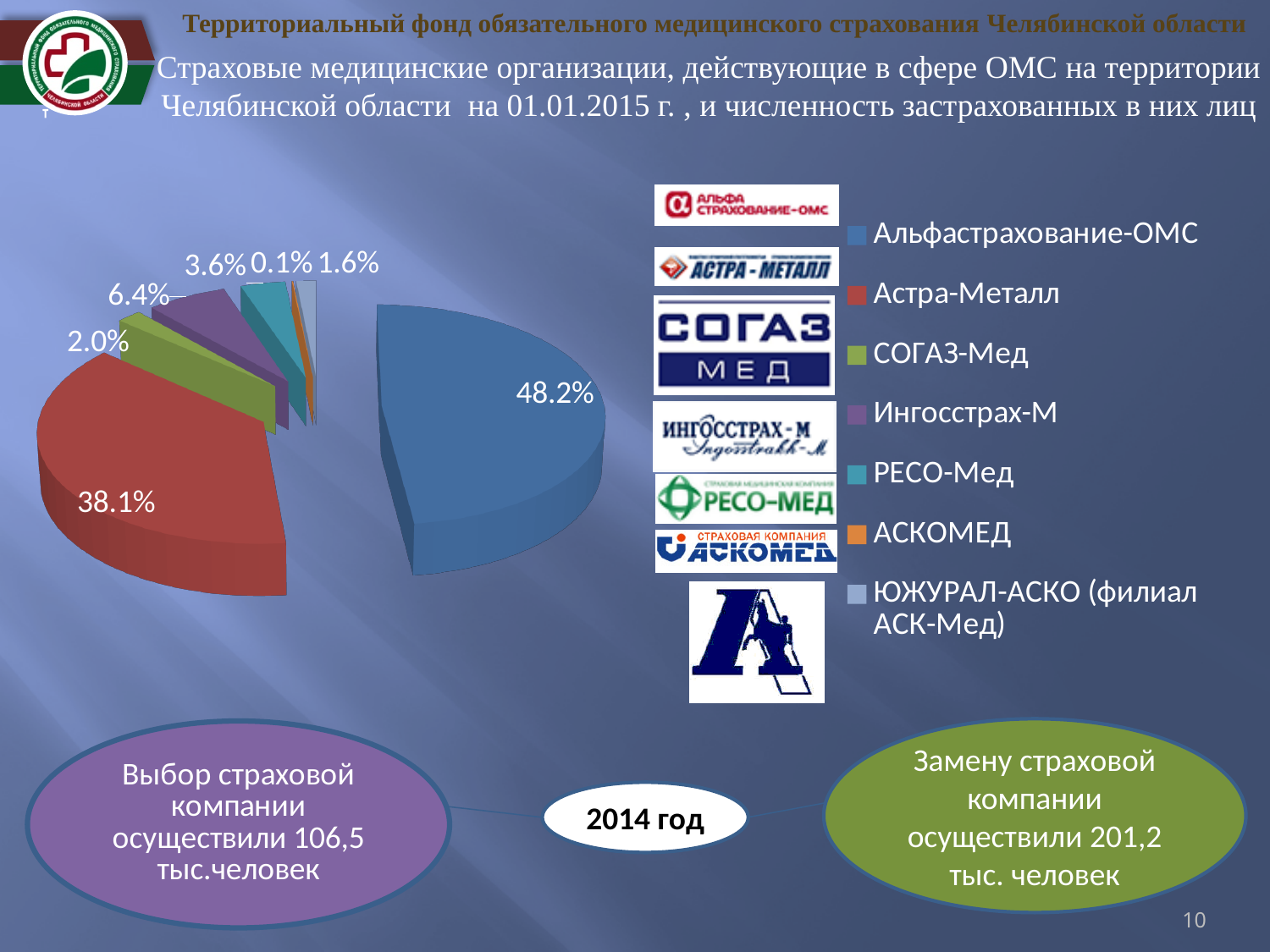
Which insurance organisation has the largest share of the pie? Альфастрахование-ОМС What is the difference between the shares of Альфастрахование-ОМС and Астра-Металл? 10.1% What is the value shown for СОГАЗ-Мед? 2.0% Which insurance organisation has the smallest share of the pie? АСКОМЕД What share of the pie does Астра-Металл hold? 38.1% What share of the pie does Альфастрахование-ОМС hold? 48.2% What is the value shown for АСКОМЕД? 0.1% What is the value shown for Ингосстрах-М? 6.4% Which has a larger share, Ингосстрах-М or РЕСО-Мед? Ингосстрах-М How many insurance organisations are listed in the chart legend? 7 What type of chart is shown on the slide? pie chart What is the value shown for РЕСО-Мед? 3.6%